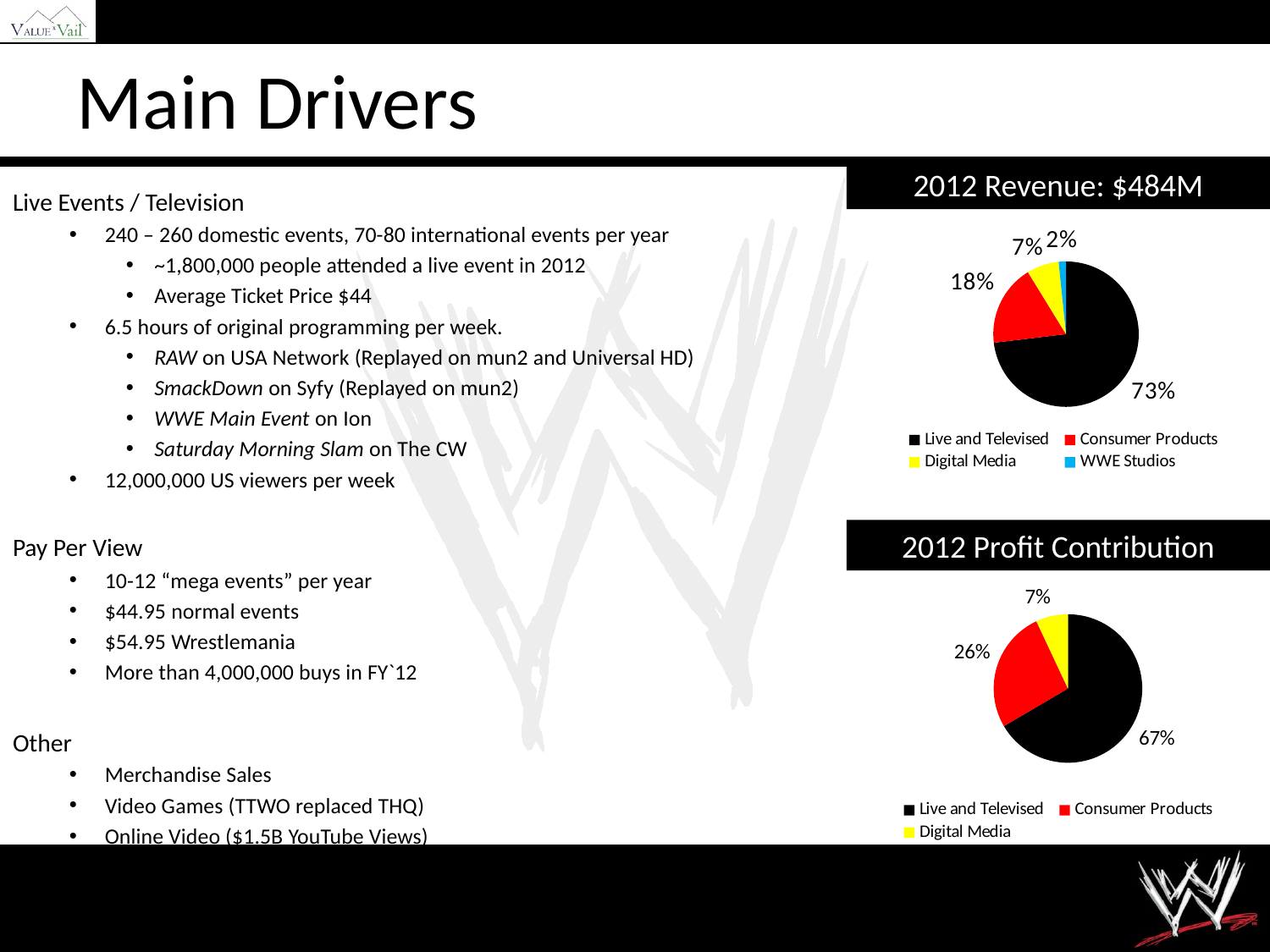
In the 2012 Profit Contribution chart, how many categories are shown? 3 In the 2012 Revenue chart, what share of revenue comes from Live and Televised? 73% In the 2012 Revenue chart, what is the difference in percentage points between Consumer Products and Digital Media? 11 In the 2012 Revenue chart, what share of revenue comes from WWE Studios? 2% In the 2012 Revenue chart, how many categories does the legend list? 4 What kind of chart is the 2012 Profit Contribution chart? Pie chart In the 2012 Revenue chart, what colour is the Digital Media slice? Yellow In the 2012 Revenue chart, which category has the smallest slice? WWE Studios In the 2012 Profit Contribution chart, what share comes from Consumer Products? 26% In the 2012 Profit Contribution chart, which category has the largest slice? Live and Televised In the 2012 Profit Contribution chart, which is larger: Consumer Products or Digital Media? Consumer Products